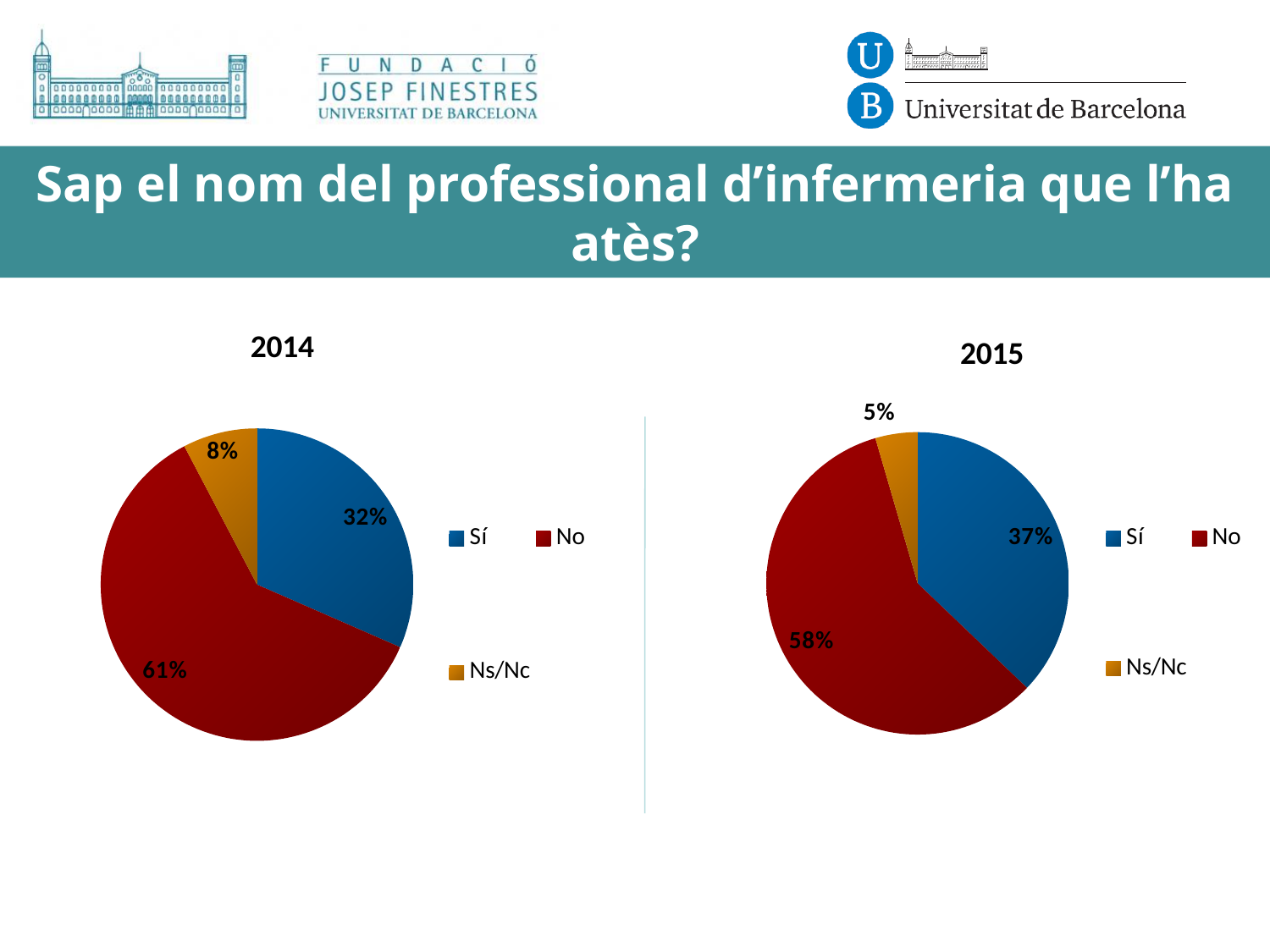
In the 2015 pie chart, what percentage is shown for "Sí"? 37% In the 2014 pie chart, what share of the pie does "Sí" represent? 32% In the 2014 pie chart, which category has the largest slice? No How many categories does the 2014 pie chart show? 3 What colour represents "No" in the 2015 pie chart? Red What type of chart is used for the 2015 data? Pie chart In the 2015 pie chart, what percentage is shown for "Ns/Nc"? 5% In the 2015 pie chart, what is the difference between the "No" and "Sí" percentages? 21% In the 2014 pie chart, what percentage is shown for "Ns/Nc"? 8% In the 2014 pie chart, what percentage is shown for "No"? 61% Which is larger: the "Sí" share in the 2014 chart or the "Sí" share in the 2015 chart? 2015 In the 2015 pie chart, which category has the smallest slice? Ns/Nc